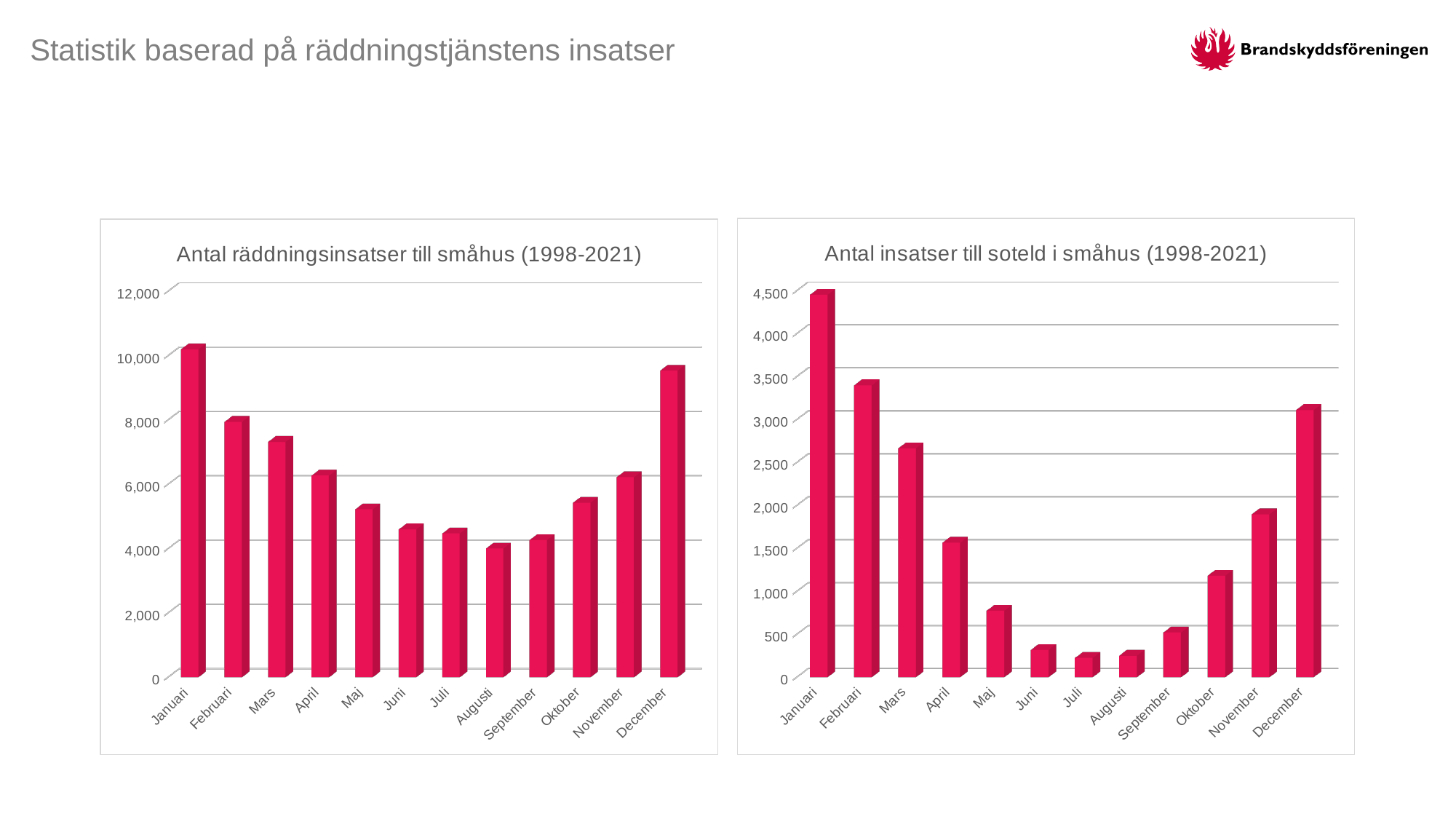
In the chart 'Antal insatser till soteld i småhus (1998-2021)', which month has the highest value? Januari In the chart 'Antal insatser till soteld i småhus (1998-2021)', is the value for Oktober greater or less than 1,500? less In the chart 'Antal insatser till soteld i småhus (1998-2021)', is the value for Februari greater or less than 3,000? greater In the chart 'Antal insatser till soteld i småhus (1998-2021)', do the values rise or fall from Januari to Juli? fall What kind of chart is the right-hand chart on the slide? bar chart In the chart 'Antal räddningsinsatser till småhus (1998-2021)', which month has the lowest value? Augusti How many months are shown on the x axis of the chart 'Antal räddningsinsatser till småhus (1998-2021)'? 12 In the chart 'Antal insatser till soteld i småhus (1998-2021)', which month has the lowest value? Juli In the chart 'Antal räddningsinsatser till småhus (1998-2021)', is the value for Maj greater or less than 6,000? less In the chart 'Antal räddningsinsatser till småhus (1998-2021)', which is larger, the value for Februari or the value for December? December In the chart 'Antal räddningsinsatser till småhus (1998-2021)', which month has the highest value? Januari